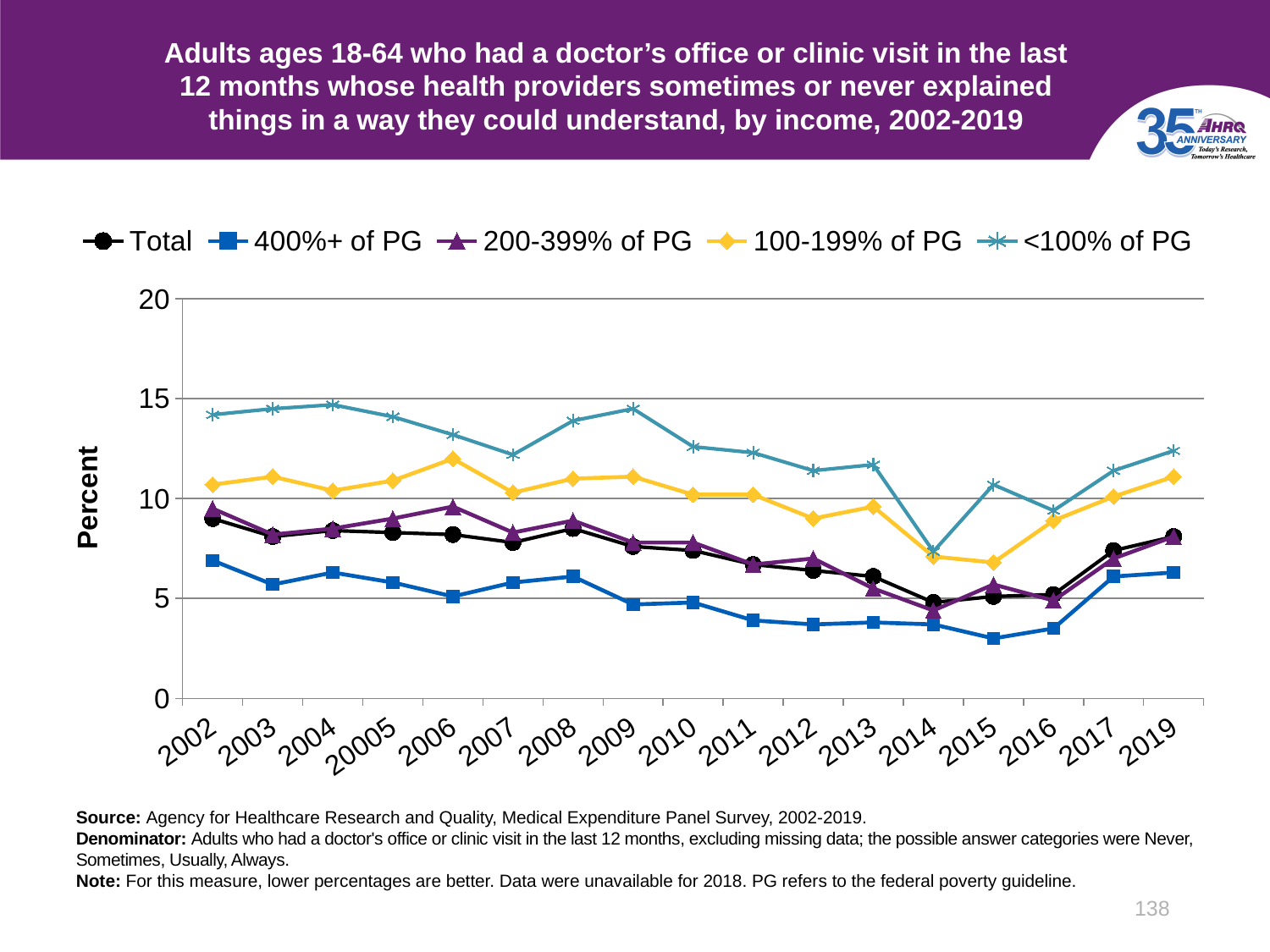
What kind of chart is shown on the slide? Line chart How many years are plotted along the x axis? 17 How many series does the legend list? 5 Is the value for <100% of PG in 2002 greater or less than 10? greater In which year is the value for <100% of PG lowest? 2014 Which income group has the highest value in 2002? <100% of PG Is the value for 400%+ of PG in 2015 greater or less than 5? less What is the label on the y axis? Percent Which income group has the lowest value in 2015? 400%+ of PG Is the value for <100% of PG in 2014 greater or less than 10? less In 2002, which is larger: the value for <100% of PG or the value for 400%+ of PG? <100% of PG